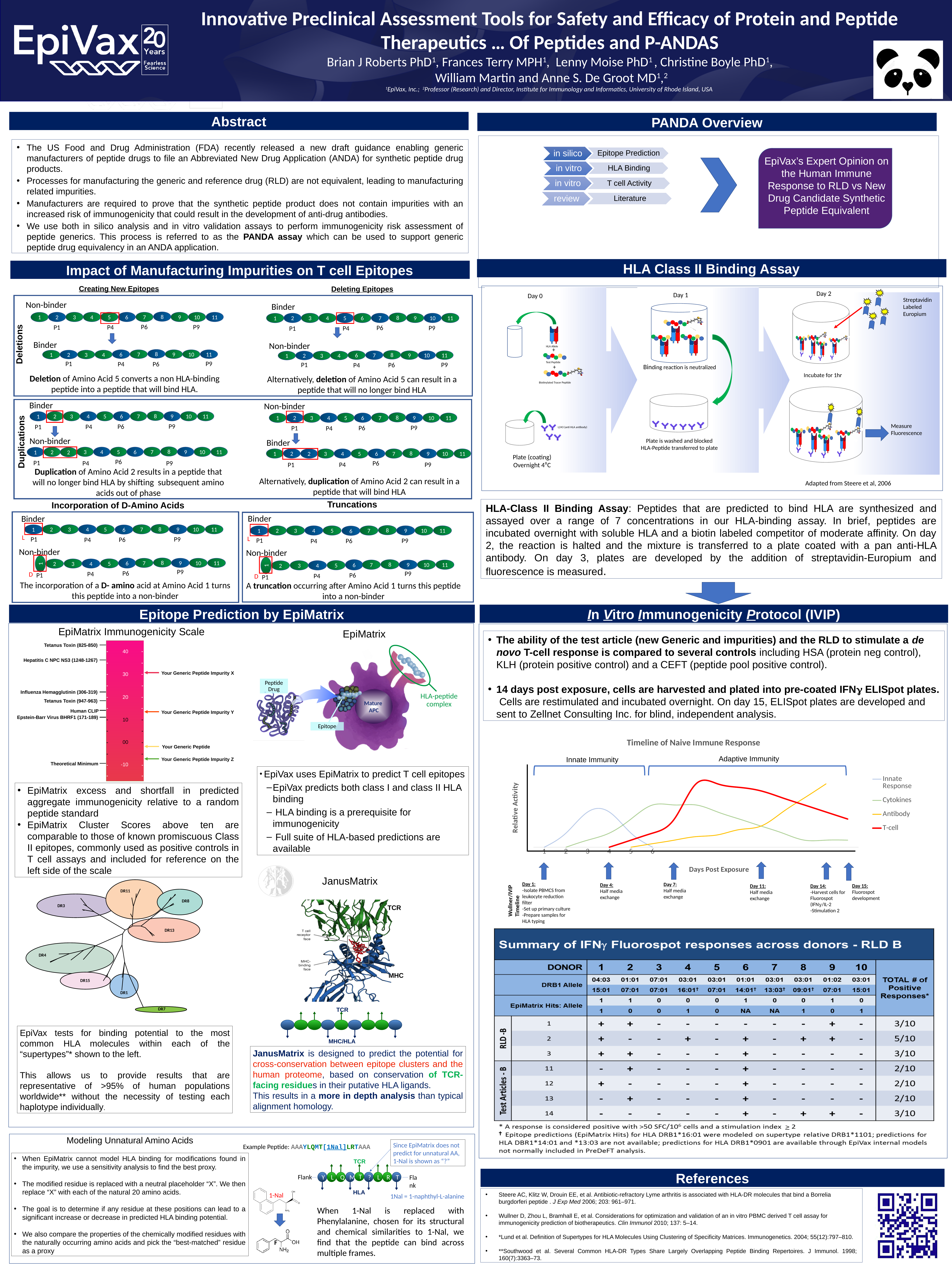
In the 'Timeline of Naive Immune Response' chart, which series is highest at the right end of the x axis? Antibody In the 'Timeline of Naive Immune Response' chart, at the right end of the x axis, which is larger: Antibody or T-cell? Antibody How many series does the legend of the 'Timeline of Naive Immune Response' chart list? 4 What are the legend entries of the 'Timeline of Naive Immune Response' chart? Innate Response, Cytokines, Antibody, T-cell In the 'Timeline of Naive Immune Response' chart, which series peaks before the Cytokines series? Innate Response In the 'Timeline of Naive Immune Response' chart, which series reaches its peak earliest along the x axis? Innate Response In the 'Timeline of Naive Immune Response' chart, does the T-cell series rise or fall after reaching its peak? fall What is the x-axis label of the 'Timeline of Naive Immune Response' chart? Days Post Exposure What kind of chart is the 'Timeline of Naive Immune Response' chart? line chart In the 'Timeline of Naive Immune Response' chart, does the Antibody series rise or fall along the x axis? rise